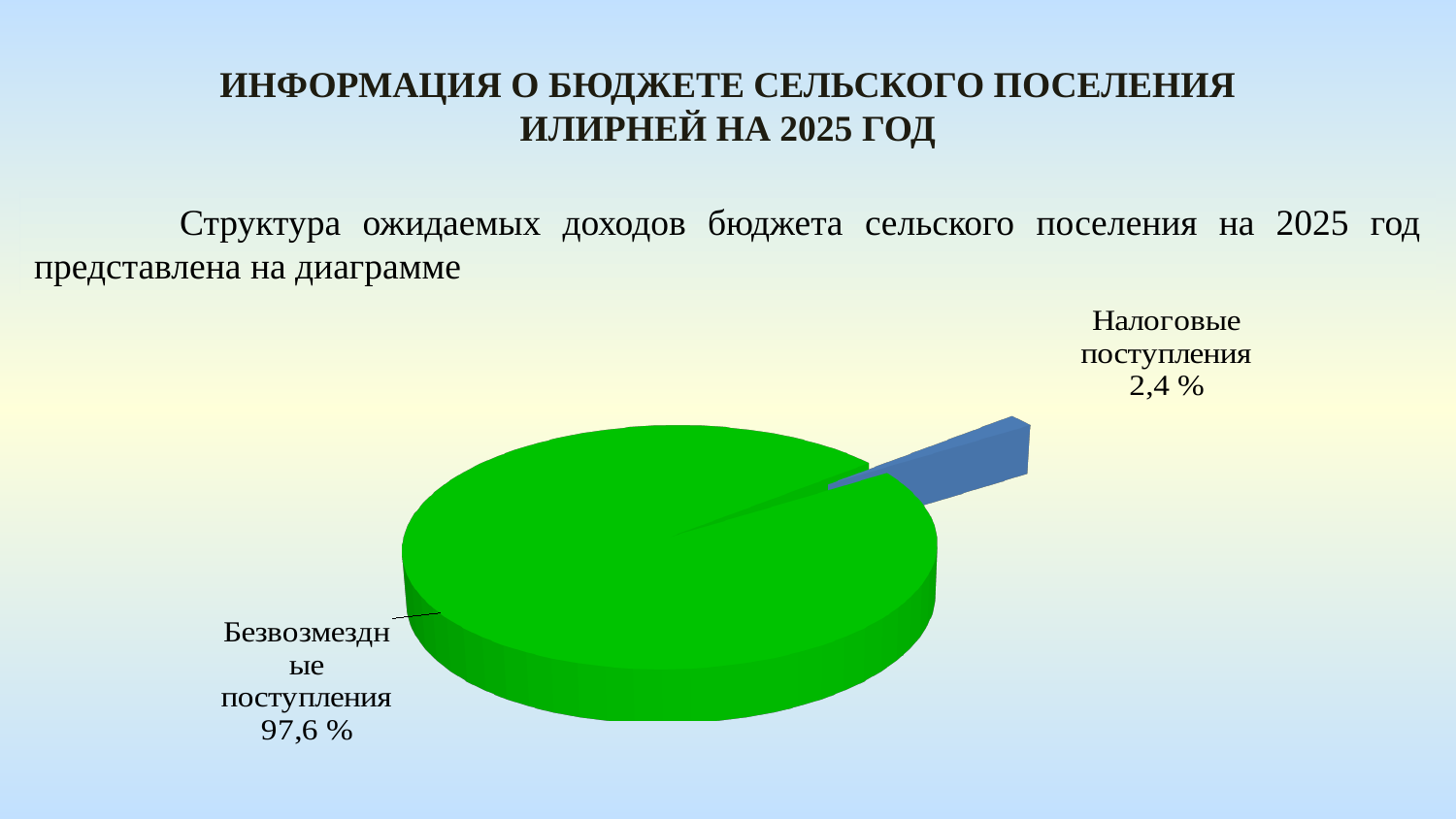
What share of the pie does Безвозмездные поступления have? 97,6 % Which category has the largest slice of the pie? Безвозмездные поступления Which is larger: Налоговые поступления or Безвозмездные поступления? Безвозмездные поступления What colour is the slice for Налоговые поступления? blue What share of the pie does Налоговые поступления have? 2,4 % What kind of chart is shown on the slide? pie chart What is the difference in percentage points between Безвозмездные поступления and Налоговые поступления? 95,2 How many slices does the pie chart have? 2 Which category has the smallest slice of the pie? Налоговые поступления What colour is the slice for Безвозмездные поступления? green